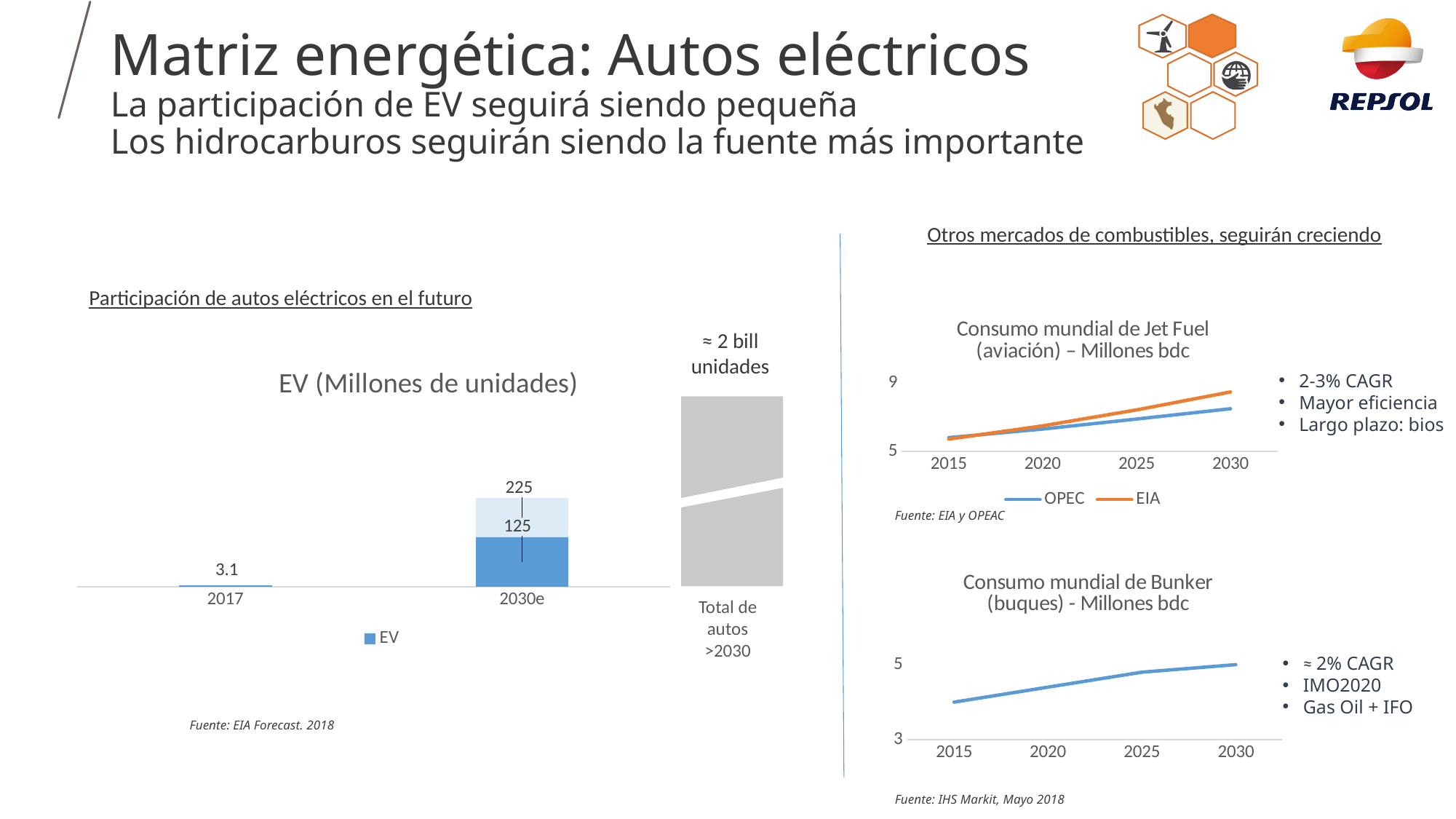
On the 'EV (Millones de unidades)' chart, what is the value for 2017? 3.1 On the 'EV (Millones de unidades)' chart, how many categories are shown on the x axis? 2 On the 'EV (Millones de unidades)' chart, what kind of chart is it? bar chart On the 'Consumo mundial de Jet Fuel (aviación) – Millones bdc' chart, what kind of chart is it? line chart On the 'EV (Millones de unidades)' chart, which category has the larger value, 2017 or 2030e? 2030e On the 'EV (Millones de unidades)' chart, what two data labels are printed on the 2030e bar? 125 and 225 On the 'Consumo mundial de Jet Fuel (aviación) – Millones bdc' chart, do the values rise or fall from 2015 to 2030? rise On the 'Consumo mundial de Jet Fuel (aviación) – Millones bdc' chart, how many series does the legend list? 2 On the 'Consumo mundial de Jet Fuel (aviación) – Millones bdc' chart, which series is higher in 2030, OPEC or EIA? EIA On the 'Consumo mundial de Bunker (buques) - Millones bdc' chart, is the value for 2015 greater or less than 5? less On the 'EV (Millones de unidades)' chart, what entry does the legend list? EV On the 'Consumo mundial de Bunker (buques) - Millones bdc' chart, how many years are labelled on the x axis? 4